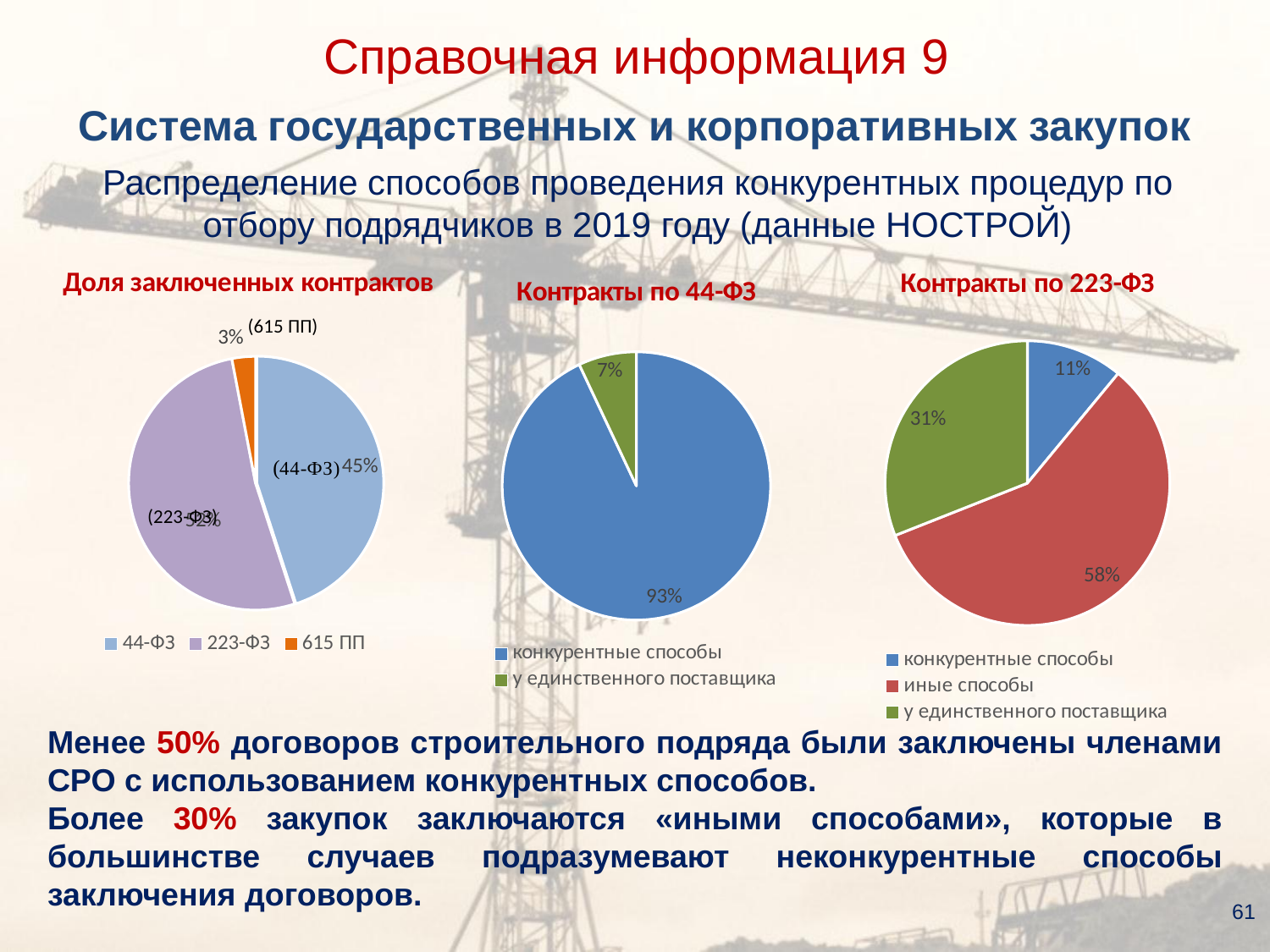
In the chart titled "Контракты по 44-ФЗ", what share is labelled for у единственного поставщика? 7% In the chart titled "Контракты по 223-ФЗ", what is the difference between the shares for иные способы and у единственного поставщика? 27% In the chart titled "Доля заключенных контрактов", which category has the smallest slice? 615 ПП In the chart titled "Контракты по 223-ФЗ", which category has the largest slice? иные способы In the chart titled "Контракты по 223-ФЗ", what share is labelled for иные способы? 58% In the chart titled "Контракты по 44-ФЗ", what share is labelled for конкурентные способы? 93% In the chart titled "Контракты по 223-ФЗ", what share is labelled for конкурентные способы? 11% What kind of chart is the chart titled "Контракты по 44-ФЗ"? pie chart In the chart titled "Контракты по 223-ФЗ", what share is labelled for у единственного поставщика? 31% In the chart titled "Доля заключенных контрактов", what share is labelled for 615 ПП? 3% In the chart titled "Доля заключенных контрактов", what share is labelled for 44-ФЗ? 45% How many entries does the legend of the chart titled "Контракты по 223-ФЗ" list? 3